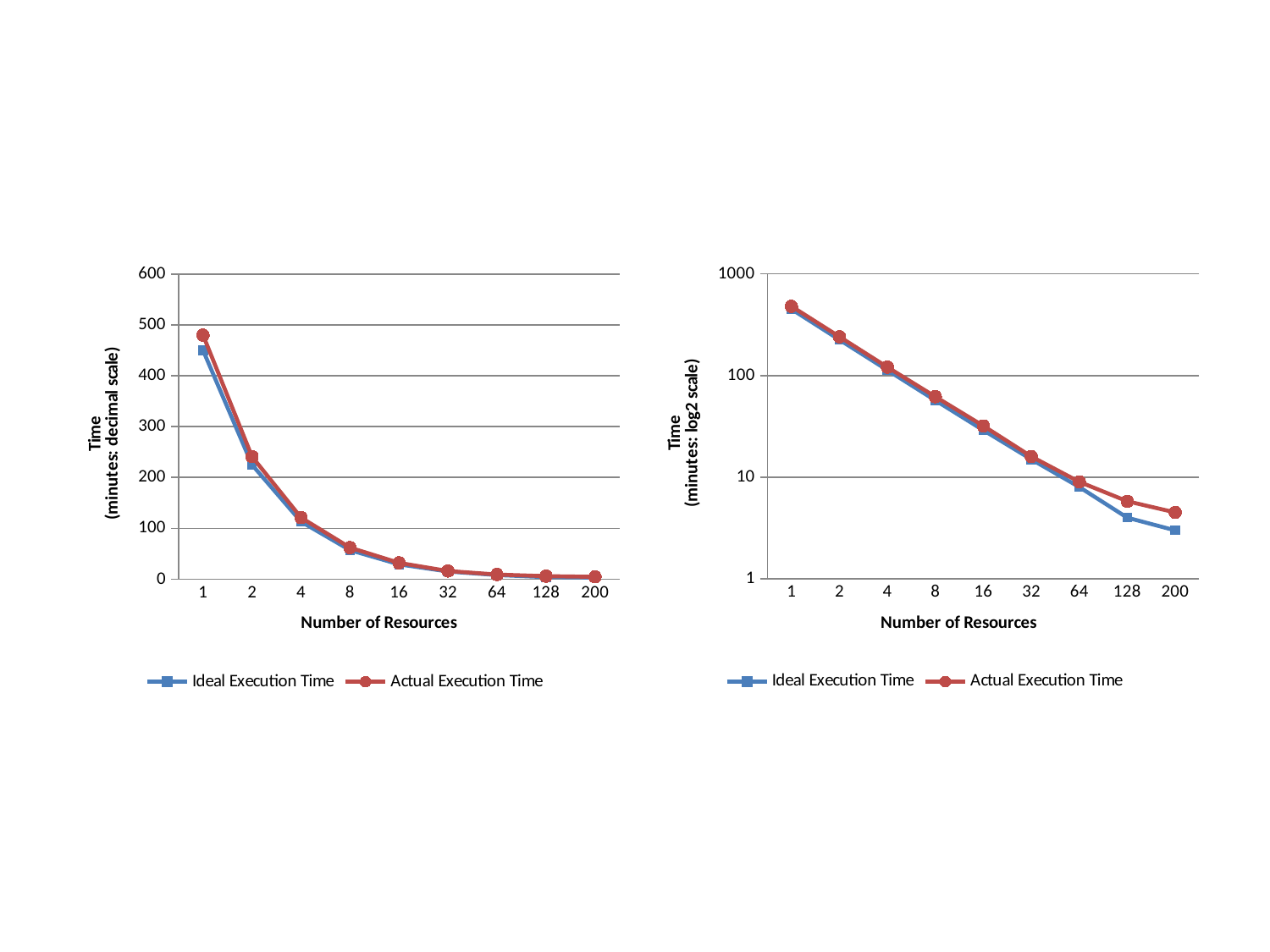
In the right chart, at 200 resources, which series has the larger value: Ideal Execution Time or Actual Execution Time? Actual Execution Time What is the x-axis title of the left chart? Number of Resources In the right chart, is the Ideal Execution Time at 200 resources greater or less than 10? less What kind of chart is the left chart (decimal scale)? line chart In the left chart, is the Ideal Execution Time at 2 resources greater or less than 300? less In the left chart, is the Actual Execution Time at 8 resources greater or less than 100? less How many points along the Number of Resources axis does the right chart plot for each series? 9 How many series does the legend of the left chart list? 2 What is the y-axis title of the right chart? Time (minutes: log2 scale) What kind of chart is the right chart (log2 scale)? line chart In the left chart, do the execution times rise or fall as the number of resources increases? fall